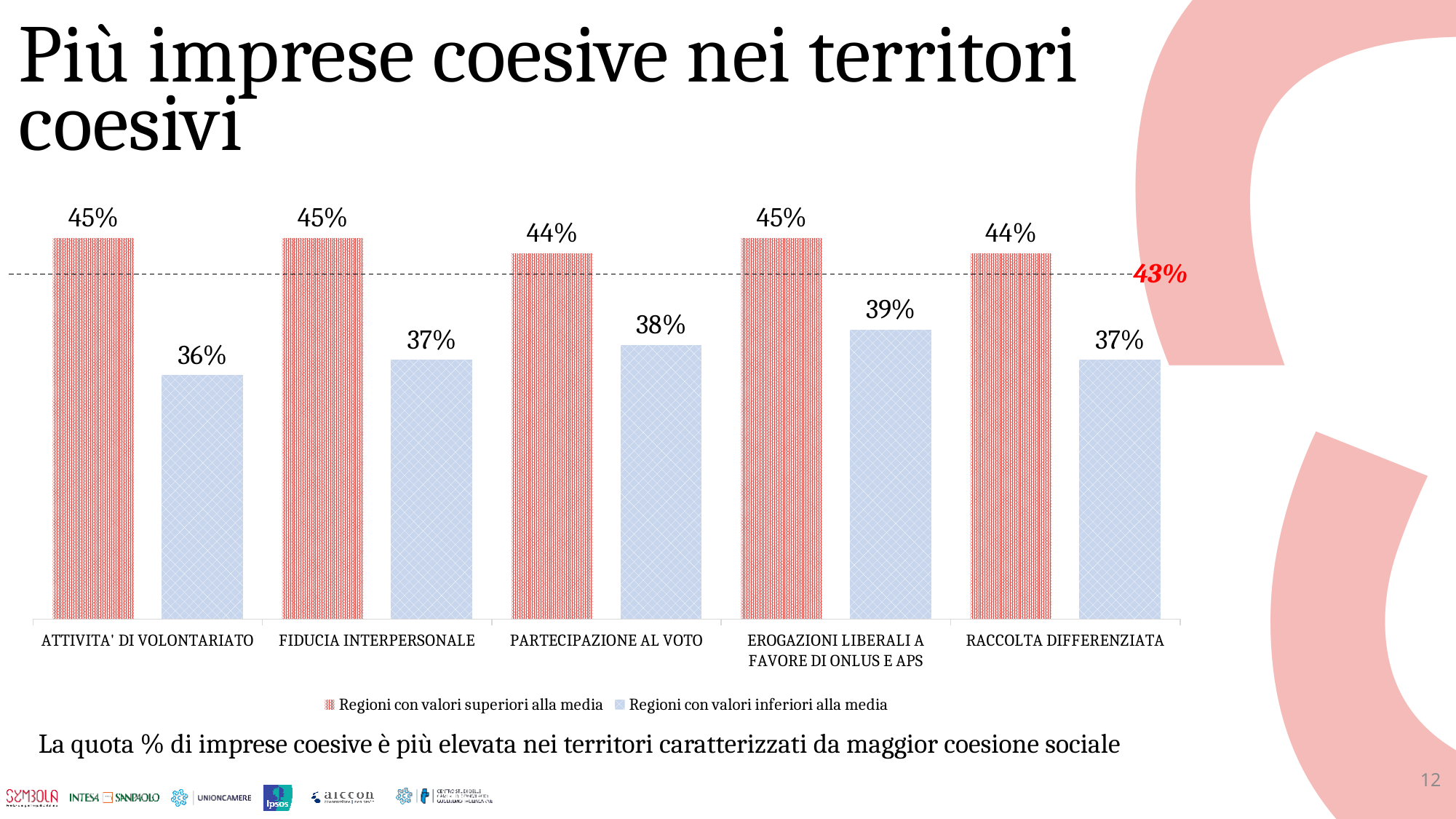
What is the value for 'Regioni con valori superiori alla media' in the ATTIVITA' DI VOLONTARIATO category? 45% What kind of chart is shown on the slide? Bar chart What is the difference between the two series in the RACCOLTA DIFFERENZIATA category? 7% What value is marked by the dashed horizontal reference line on the chart? 43% What is the difference between the two series in the ATTIVITA' DI VOLONTARIATO category? 9% How many categories are shown on the x axis of the chart? 5 In the FIDUCIA INTERPERSONALE category, which series has the larger value? Regioni con valori superiori alla media What is the value for 'Regioni con valori inferiori alla media' in the PARTECIPAZIONE AL VOTO category? 38% Which category has the highest value for 'Regioni con valori inferiori alla media'? EROGAZIONI LIBERALI A FAVORE DI ONLUS E APS Which category has the lowest value for 'Regioni con valori inferiori alla media'? ATTIVITA' DI VOLONTARIATO What is the value for 'Regioni con valori inferiori alla media' in the EROGAZIONI LIBERALI A FAVORE DI ONLUS E APS category? 39% How many series does the chart legend list? 2